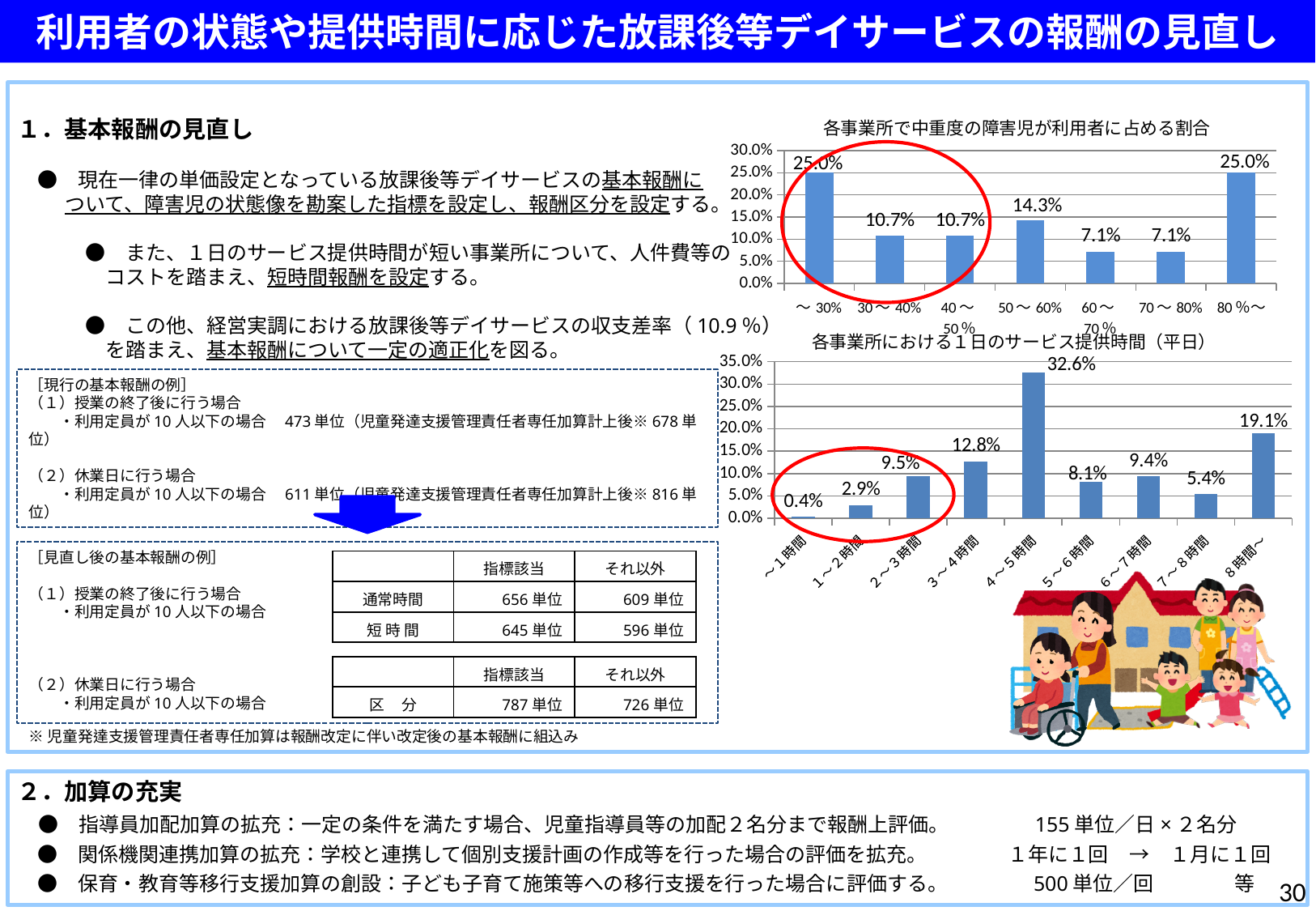
What kind of chart is the one titled 各事業所における１日のサービス提供時間（平日）? Bar chart In the chart titled 各事業所における１日のサービス提供時間（平日）, which category has the highest value? 4～5時間 In the chart titled 各事業所における１日のサービス提供時間（平日）, what is the value for 8時間～? 19.1% In the chart titled 各事業所における１日のサービス提供時間（平日）, which category has the lowest value? ～1時間 In the chart titled 各事業所で中重度の障害児が利用者に占める割合, what is the value for the 50～60% category? 14.3% In the chart titled 各事業所における１日のサービス提供時間（平日）, how many categories are shown on the x axis? 9 In the chart titled 各事業所における１日のサービス提供時間（平日）, what is the difference between the values for 4～5時間 and 8時間～? 13.5% In the chart titled 各事業所で中重度の障害児が利用者に占める割合, what is the value for the 30～40% category? 10.7% In the chart titled 各事業所における１日のサービス提供時間（平日）, what is the value for 3～4時間? 12.8% In the chart titled 各事業所で中重度の障害児が利用者に占める割合, what is the difference between the values for ～30% and 60～70%? 17.9% In the chart titled 各事業所で中重度の障害児が利用者に占める割合, how many categories are shown on the x axis? 7 In the chart titled 各事業所で中重度の障害児が利用者に占める割合, which is larger, the value for 50～60% or the value for 70～80%? 50～60%